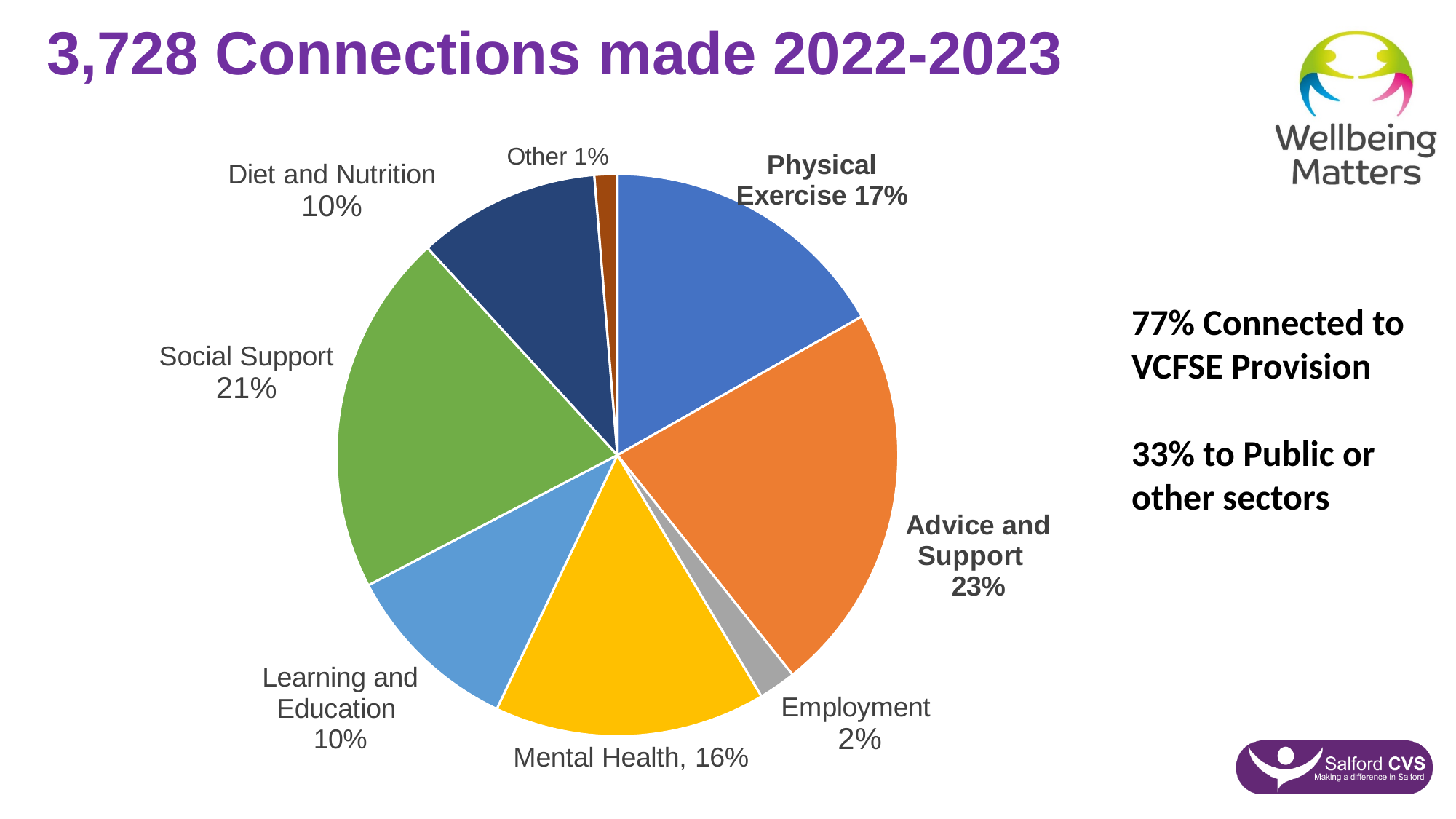
What is the title of the slide containing the chart? 3,728 Connections made 2022-2023 What is the difference in percentage points between Social Support and Physical Exercise? 4 What share of connections is for Advice and Support? 23% What share of connections is for Employment? 2% Which is larger, Physical Exercise or Mental Health? Physical Exercise What share of connections is for Social Support? 21% What colour is the Mental Health slice? Yellow What kind of chart is shown on the slide? Pie chart Which category has the smallest slice of the pie? Other How many categories are shown in the pie chart? 8 Which category has the largest slice of the pie? Advice and Support